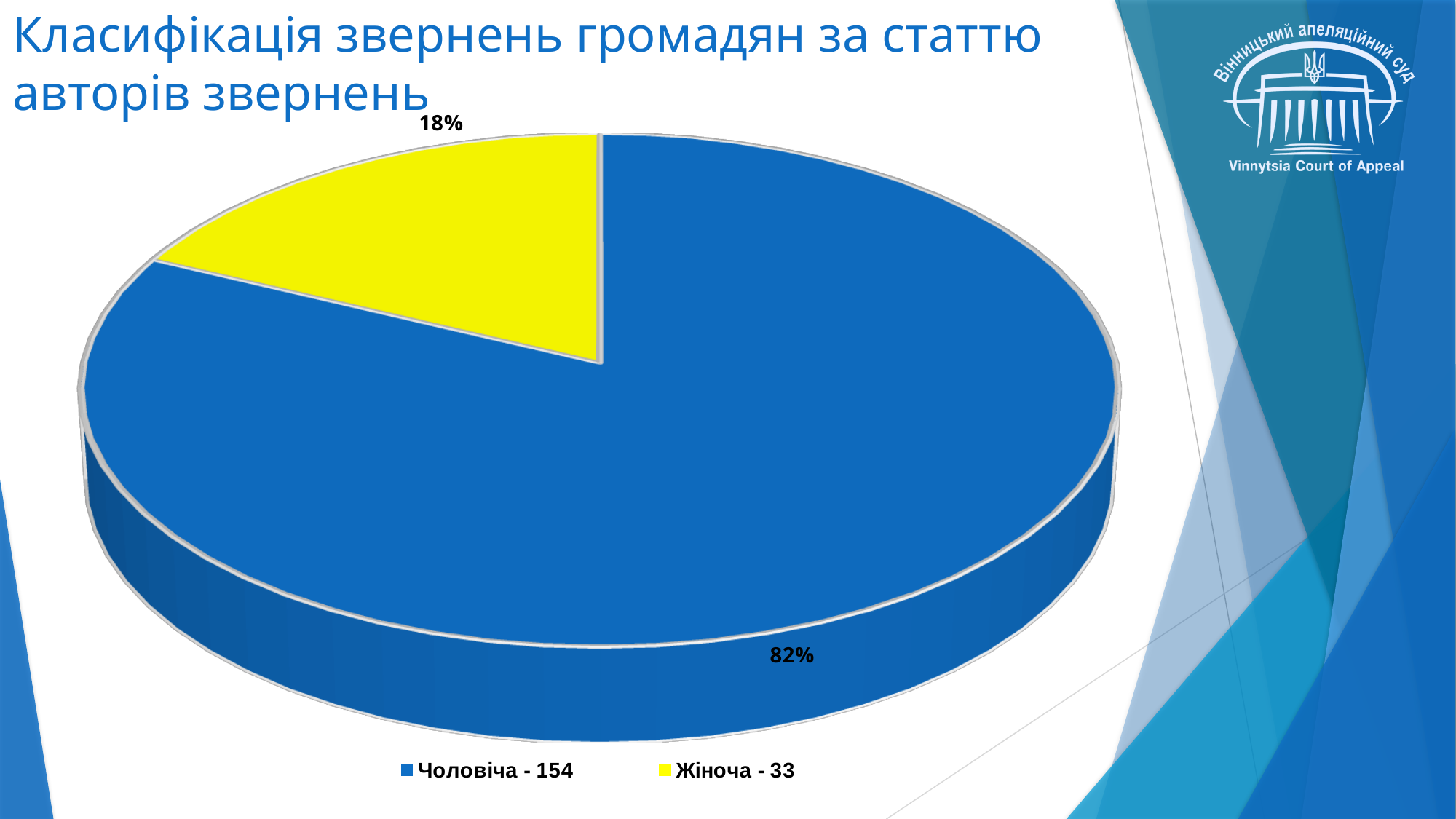
What is the difference in percentage points between the "Чоловіча" and "Жіноча" slices? 64% Which slice is larger, "Чоловіча" or "Жіноча"? Чоловіча What colour is the "Жіноча - 33" slice? yellow What is the title of the slide containing the chart? Класифікація звернень громадян за статтю авторів звернень Which category has the smallest slice of the pie? Жіноча - 33 What kind of chart is shown on the slide? pie chart How many slices does the pie chart have? 2 Which category has the largest slice of the pie? Чоловіча - 154 How many entries does the legend list? 2 What percentage share does the "Жіноча - 33" slice have? 18% What is the total of the counts shown in the legend (154 and 33)? 187 What percentage share does the "Чоловіча - 154" slice have? 82%